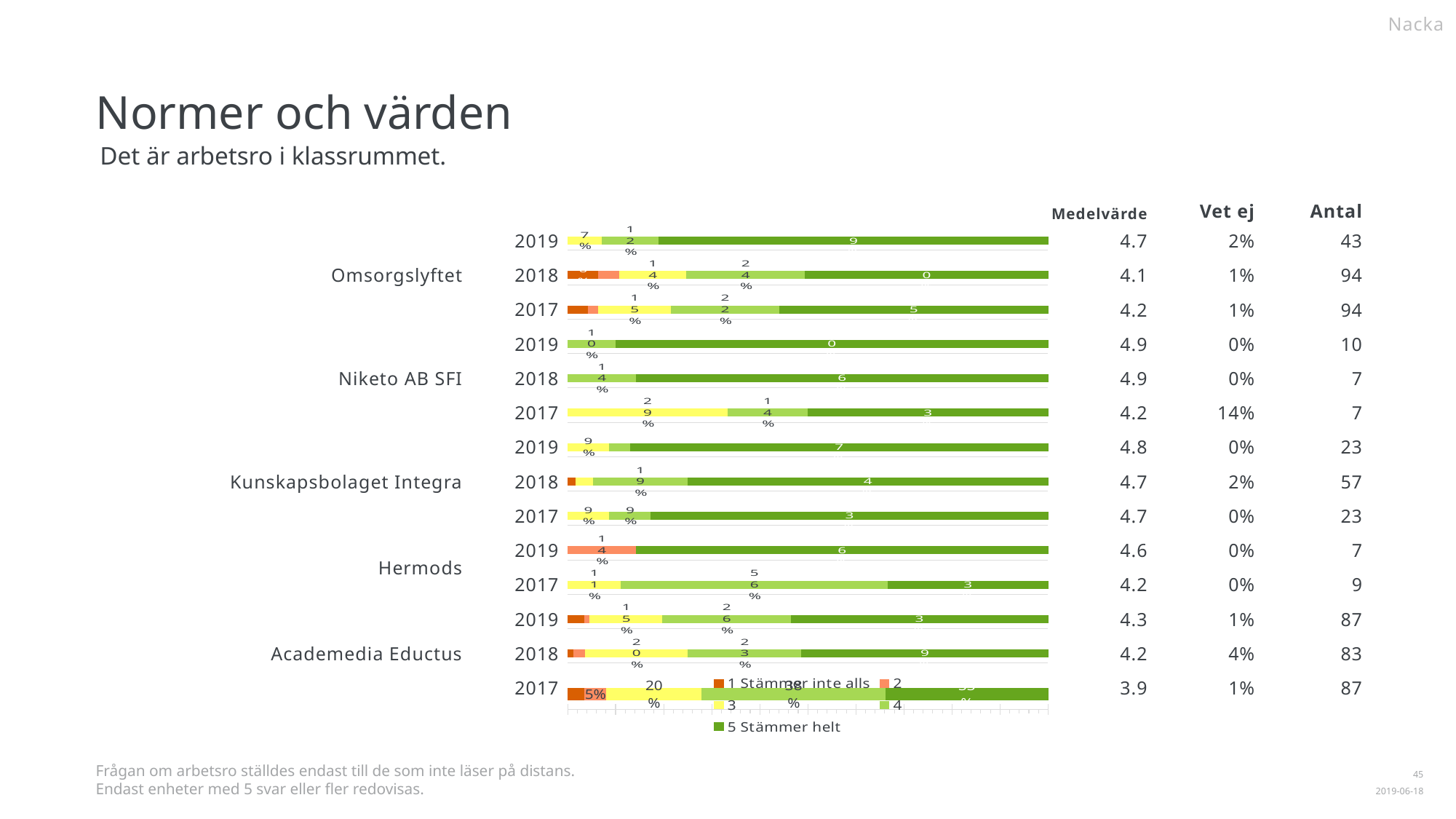
Which has the larger Antal: Omsorgslyftet 2019 or Academedia Eductus 2019? Academedia Eductus 2019 How many providers (school units) are listed along the chart's category axis? 5 Which bar has the lowest Medelvärde value? Academedia Eductus 2017 What is the label of the darkest green series in the legend? 5 Stämmer helt What percentage is shown for the '3' segment of the Omsorgslyftet 2019 bar? 7% What percentage is shown for the '4' segment of the Hermods 2017 bar? 56% What kind of chart is shown on the slide? bar chart How many bars (year rows) are plotted in the chart? 14 How many series does the chart legend list? 5 What is the Medelvärde for Kunskapsbolaget Integra 2019? 4.8 What percentage is shown for the '3' segment of the Niketo AB SFI 2017 bar? 29%